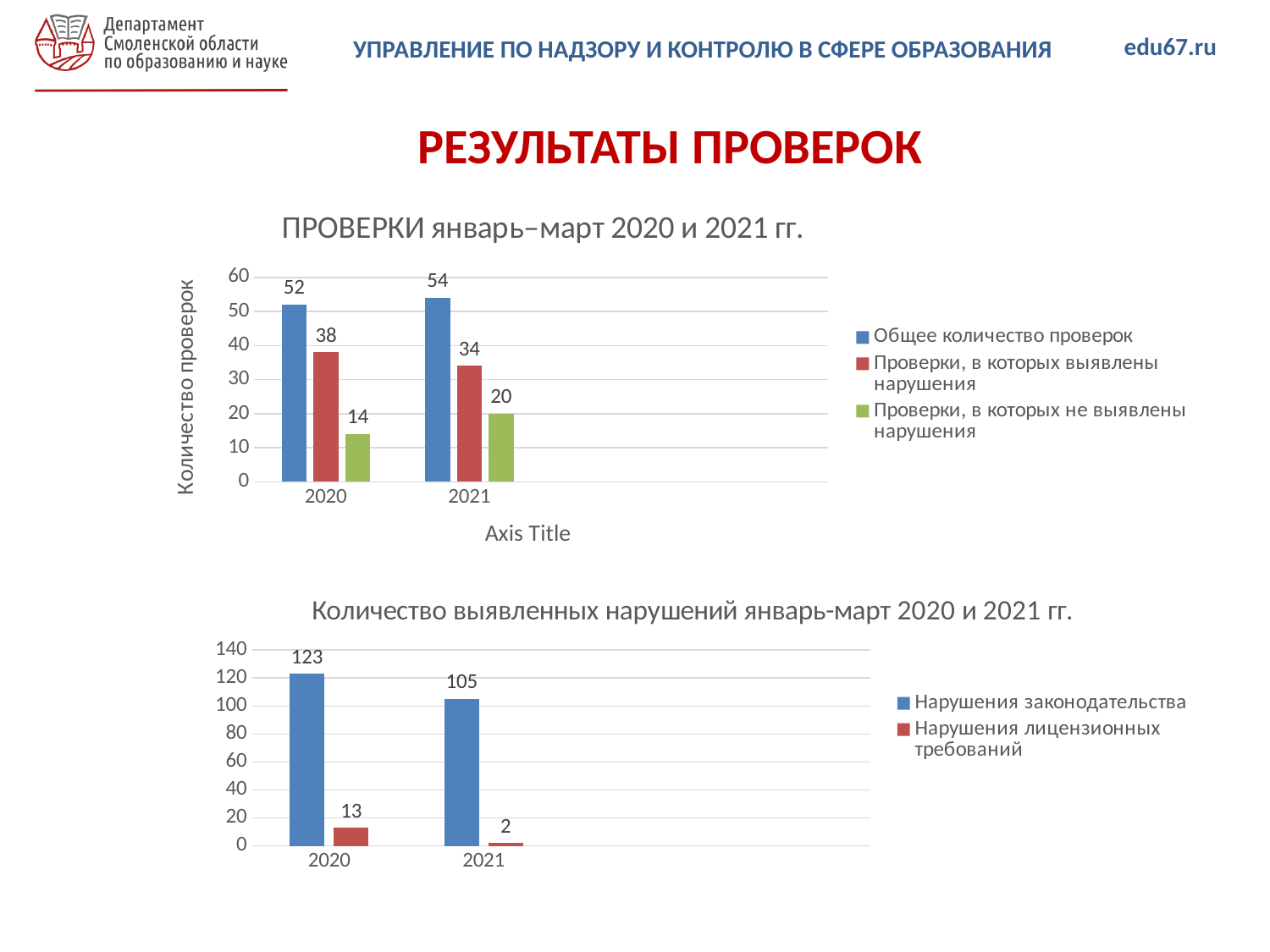
In the chart 'Количество выявленных нарушений январь-март 2020 и 2021 гг.', does the value of 'Нарушения законодательства' rise or fall from 2020 to 2021? fall In the chart 'Количество выявленных нарушений январь-март 2020 и 2021 гг.', what is the value of 'Нарушения лицензионных требований' for 2021? 2 In the chart 'ПРОВЕРКИ январь–март 2020 и 2021 гг.', which year has the higher value for 'Общее количество проверок'? 2021 What type of chart is the bottom chart on the slide? bar chart In the chart 'ПРОВЕРКИ январь–март 2020 и 2021 гг.', what is the difference between 'Проверки, в которых выявлены нарушения' in 2020 and in 2021? 4 In the chart 'ПРОВЕРКИ январь–март 2020 и 2021 гг.', what is the y-axis title? Количество проверок In the chart 'Количество выявленных нарушений январь-март 2020 и 2021 гг.', what is the difference between 'Нарушения законодательства' in 2020 and in 2021? 18 In the chart 'ПРОВЕРКИ январь–март 2020 и 2021 гг.', how many series does the legend list? 3 In the chart 'ПРОВЕРКИ январь–март 2020 и 2021 гг.', what is the value of 'Проверки, в которых не выявлены нарушения' for 2021? 20 In the chart 'ПРОВЕРКИ январь–март 2020 и 2021 гг.', what is the value of 'Общее количество проверок' for 2020? 52 In the chart 'Количество выявленных нарушений январь-март 2020 и 2021 гг.', how many categories are shown on the x axis? 2 In the chart 'Количество выявленных нарушений январь-март 2020 и 2021 гг.', what is the value of 'Нарушения законодательства' for 2020? 123